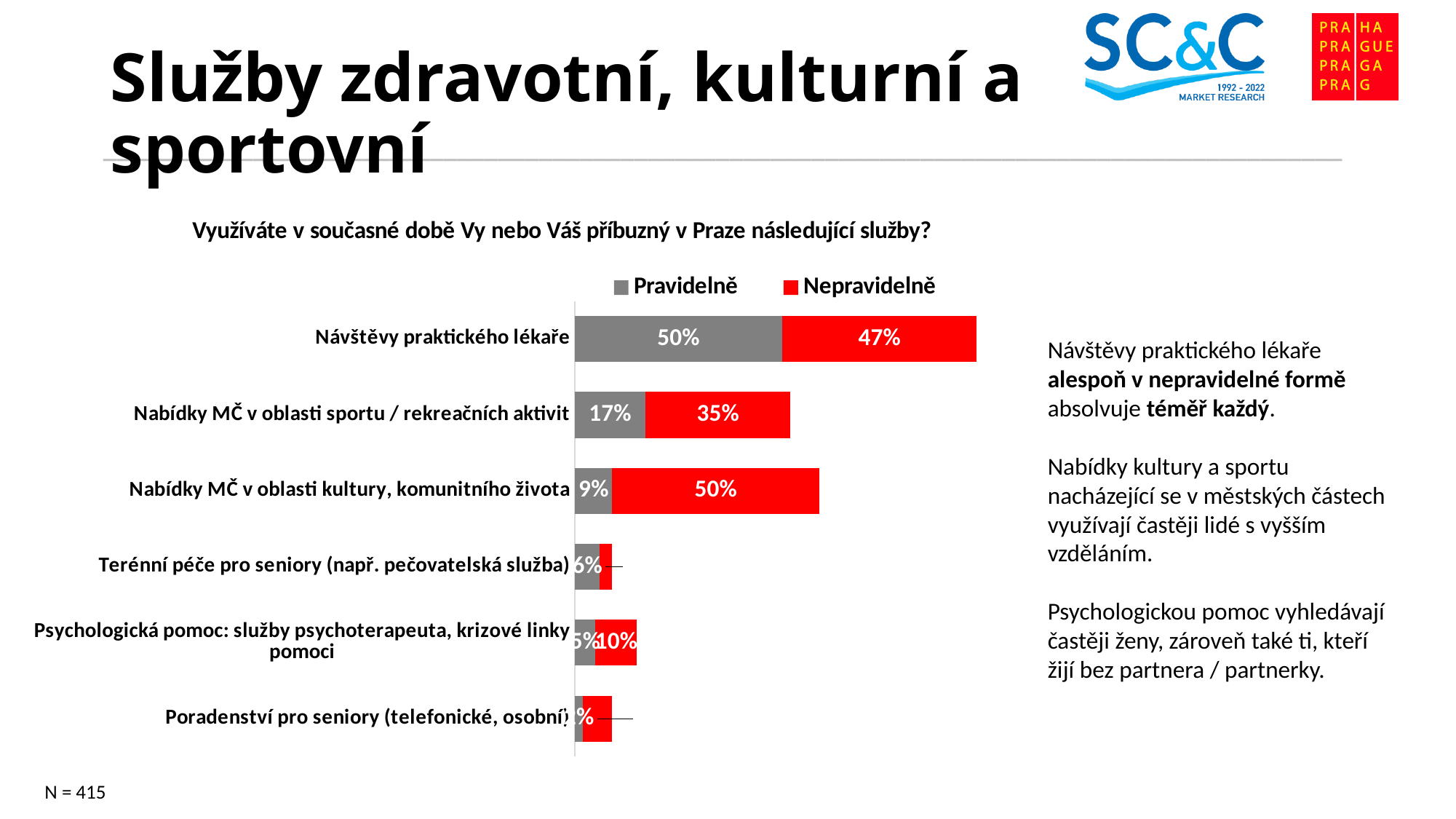
What is the Pravidelně value for Návštěvy praktického lékaře? 50% What kind of chart is shown on the slide? bar chart What is the Pravidelně value for Nabídky MČ v oblasti kultury, komunitního života? 9% What is the difference between the Nepravidelně and Pravidelně values for Nabídky MČ v oblasti kultury, komunitního života? 41% How many series does the chart legend list? 2 How many service categories are shown in the chart? 6 What is the Nepravidelně value for Nabídky MČ v oblasti sportu / rekreačních aktivit? 35% What is the total of the stacked bar for Nabídky MČ v oblasti sportu / rekreačních aktivit? 52% What is the Nepravidelně value for Psychologická pomoc: služby psychoterapeuta, krizové linky pomoci? 10% Which category has the highest Pravidelně value? Návštěvy praktického lékaře What is the Nepravidelně value for Návštěvy praktického lékaře? 47% Which colour represents the Nepravidelně series in the chart? red